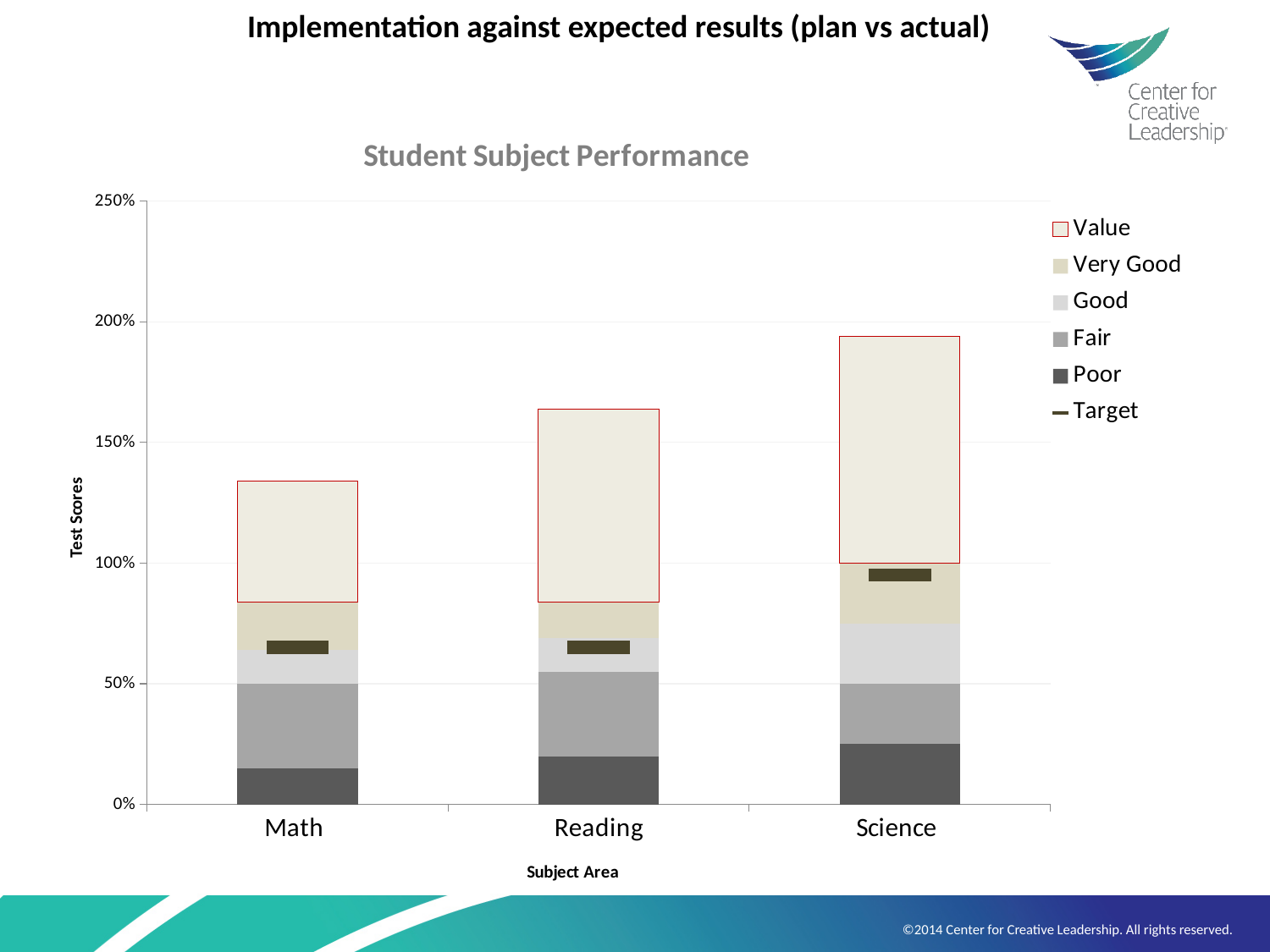
How many subject areas are shown on the x axis? 3 What is the label of the vertical axis? Test Scores How many series does the legend list? 6 Which subject area has the tallest stacked bar? Science Is the total height of the Science bar greater or less than 200%? less Is the total height of the Reading bar greater or less than 150%? greater Which stacked bar is taller, Reading or Math? Reading Which subject area has the shortest stacked bar? Math What kind of chart is shown on the slide? stacked bar chart Is the total height of the Math bar greater or less than 100%? greater What is the title of the chart? Student Subject Performance Do the stacked bar totals rise or fall moving from Math to Science along the x axis? rise